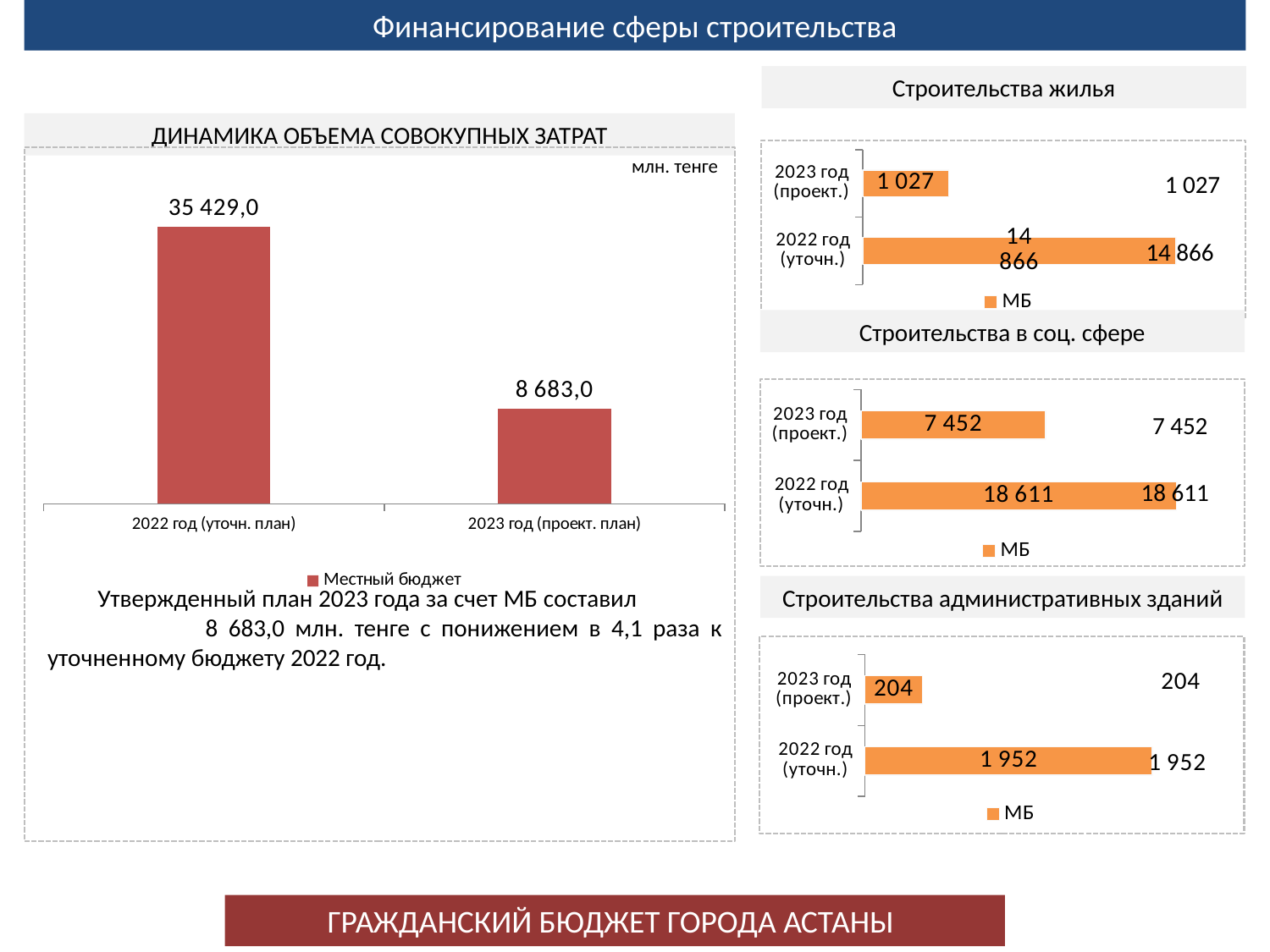
In the chart titled 'ДИНАМИКА ОБЪЕМА СОВОКУПНЫХ ЗАТРАТ', what series name does the legend show? Местный бюджет In the chart titled 'Строительства административных зданий', which category has the lowest value? 2023 год (проект.) In the chart titled 'ДИНАМИКА ОБЪЕМА СОВОКУПНЫХ ЗАТРАТ', what is the value for '2022 год (уточн. план)'? 35 429,0 What kind of chart is the chart titled 'ДИНАМИКА ОБЪЕМА СОВОКУПНЫХ ЗАТРАТ'? bar chart In the chart titled 'Строительства административных зданий', what is the value for '2022 год (уточн.)'? 1 952 In the chart titled 'Строительства в соц. сфере', what is the difference between the 2022 and 2023 values? 11 159 In the chart titled 'ДИНАМИКА ОБЪЕМА СОВОКУПНЫХ ЗАТРАТ', what is the value for '2023 год (проект. план)'? 8 683,0 In the chart titled 'Строительства жилья', what is the value for '2022 год (уточн.)'? 14 866 In the chart titled 'ДИНАМИКА ОБЪЕМА СОВОКУПНЫХ ЗАТРАТ', what is the difference between the 2022 and 2023 values? 26 746,0 In the chart titled 'ДИНАМИКА ОБЪЕМА СОВОКУПНЫХ ЗАТРАТ', which category has the highest value? 2022 год (уточн. план) In the chart titled 'Строительства в соц. сфере', what is the value for '2022 год (уточн.)'? 18 611 In the chart titled 'Строительства жилья', what is the value for '2023 год (проект.)'? 1 027